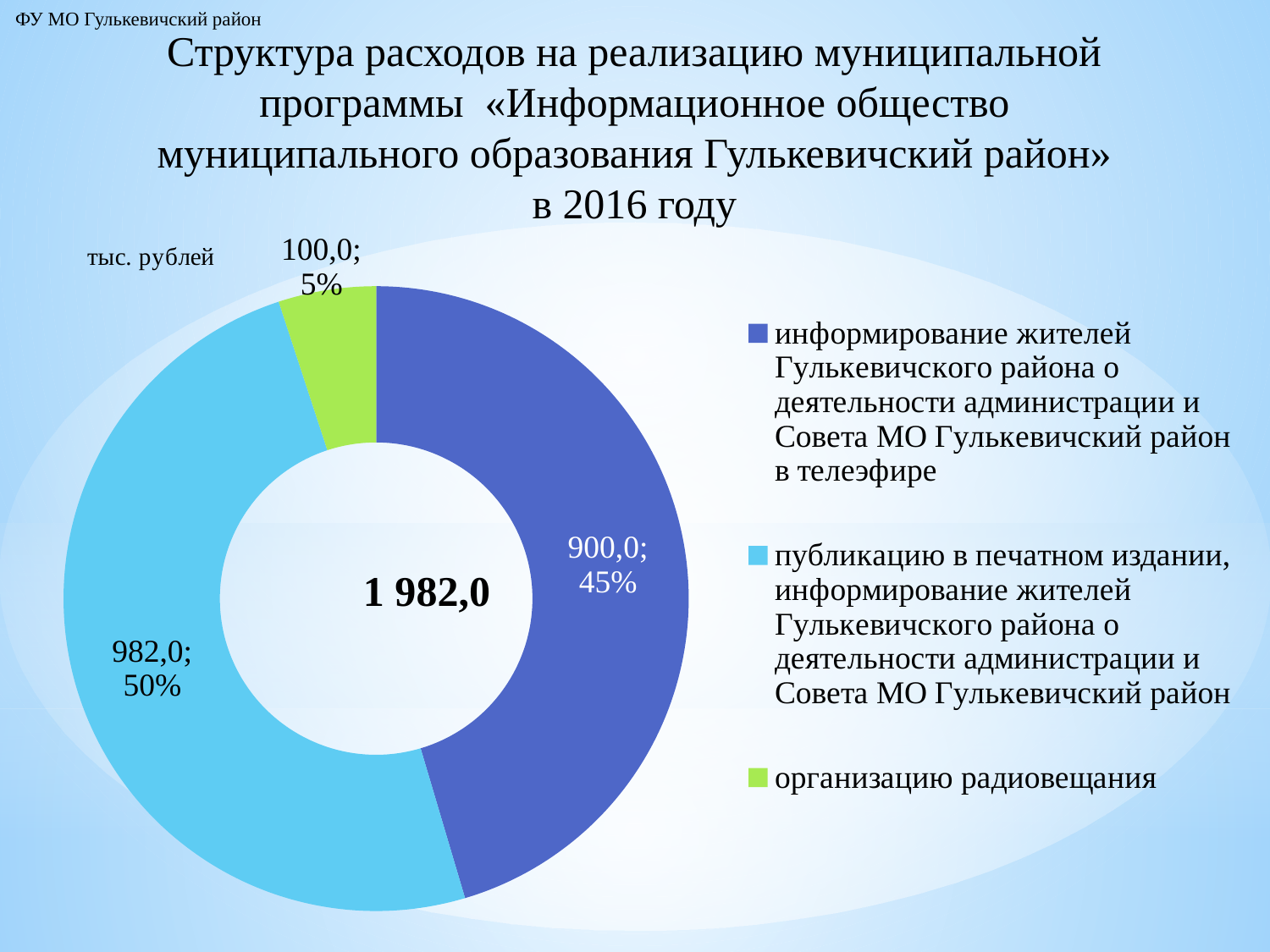
What total value is shown in the centre of the chart? 1 982,0 What is the value for «информирование жителей Гулькевичского района о деятельности администрации и Совета МО Гулькевичский район в телеэфире»? 900,0 What share of the chart does the slice for publication in print media («публикацию в печатном издании...») take? 50% What share of the chart does «организацию радиовещания» take? 5% What is the value for «публикацию в печатном издании, информирование жителей Гулькевичского района о деятельности администрации и Совета МО Гулькевичский район»? 982,0 Which category has the largest value? публикацию в печатном издании, информирование жителей Гулькевичского района о деятельности администрации и Совета МО Гулькевичский район What kind of chart is shown on the slide? doughnut (pie) chart What is the difference between the value for publication in print media (982,0) and the value for television broadcasting (900,0)? 82,0 What is the value for «организацию радиовещания»? 100,0 Which category has the smallest value? организацию радиовещания How many entries does the legend list? 3 How many slices does the chart have? 3